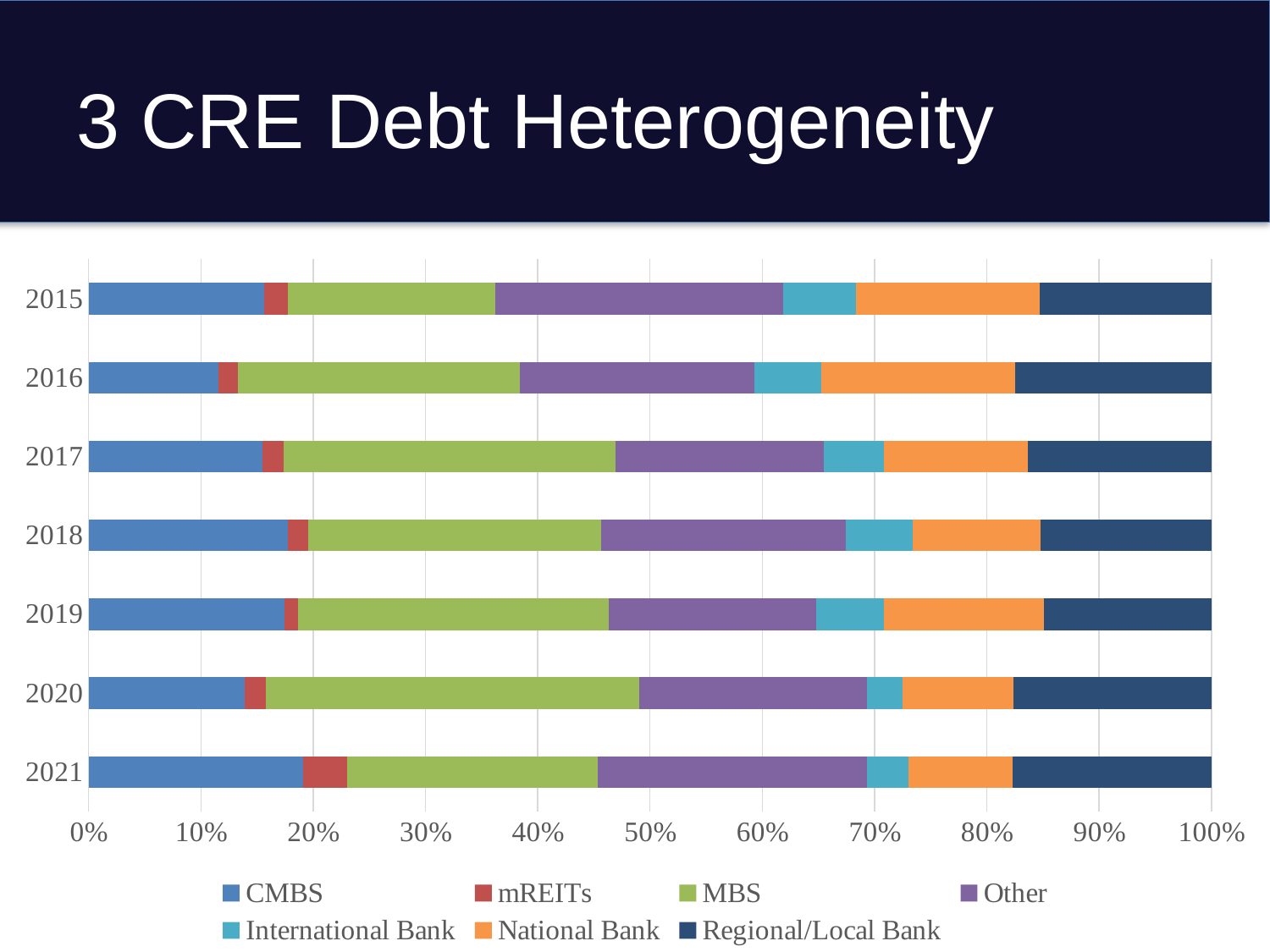
Which year has the largest mREITs segment? 2021 In 2021, which segment is larger: National Bank or Regional/Local Bank? Regional/Local Bank In 2015, which segment is larger: MBS or Other? Other Is the CMBS share for 2021 greater or less than 10%? greater How many series does the legend list? 7 Is the CMBS share for 2016 greater or less than 20%? less Which series is shown in green? MBS How many years are shown on the chart? 7 What kind of chart is shown on the slide? Stacked bar chart Which year has the smallest CMBS segment? 2016 Is the MBS share for 2020 greater or less than 30%? greater What is the total of the stacked bar for 2015? 100%